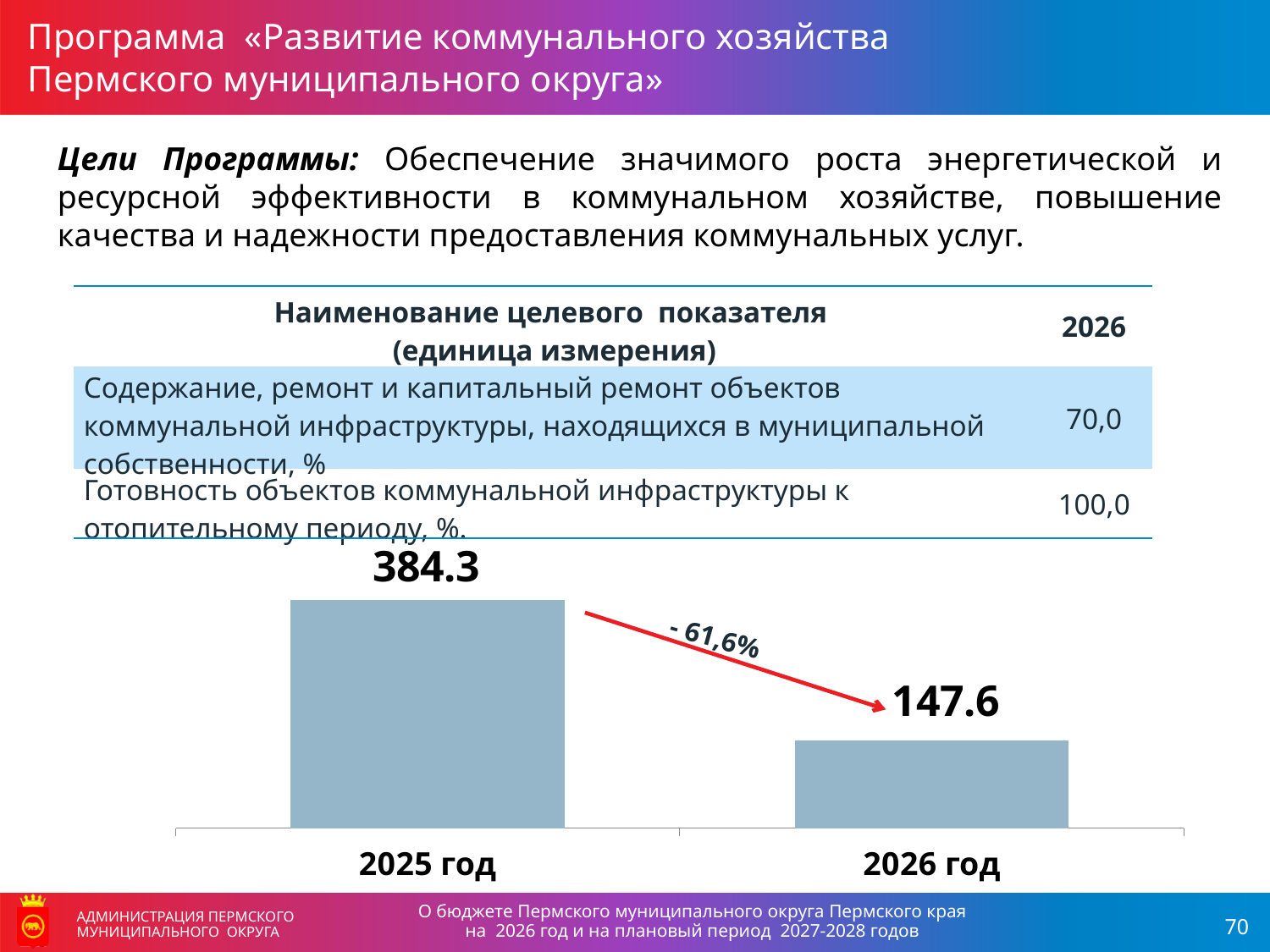
Which year has the lowest value in the bar chart? 2026 год What is the difference between the values for 2025 год and 2026 год in the bar chart? 236.7 Do the values in the chart rise or fall from 2025 год to 2026 год? fall How many bars are shown in the chart? 2 What are the category labels on the x axis of the bar chart? 2025 год, 2026 год Which is larger in the bar chart: the value for 2025 год or the value for 2026 год? 2025 год What is the value shown for 2025 год in the bar chart? 384.3 What type of chart is shown on the slide? bar chart What percentage change is written next to the arrow between the two bars? - 61,6% Which year has the highest value in the bar chart? 2025 год What is the value shown for 2026 год in the bar chart? 147.6